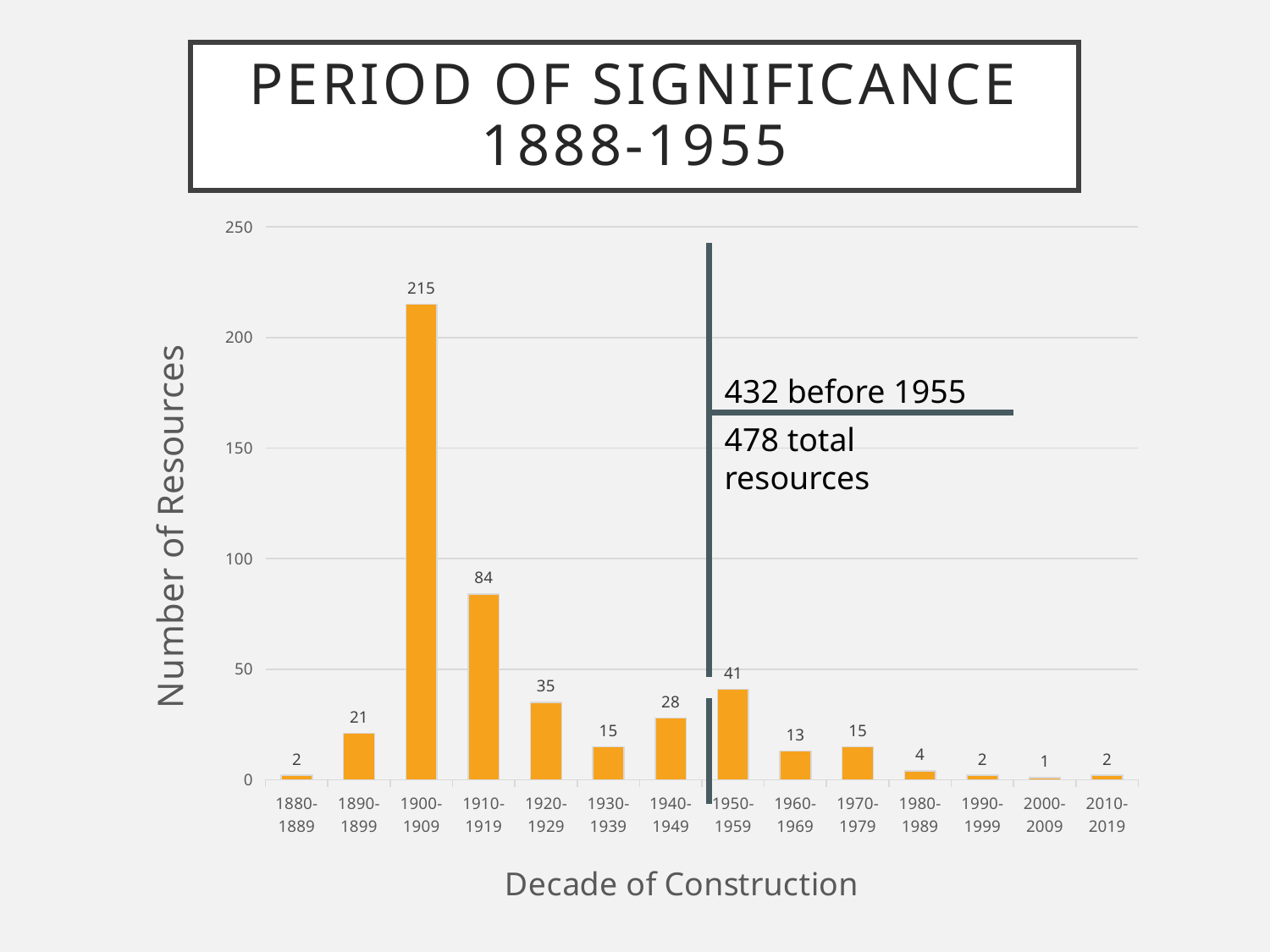
What is the label of the y axis? Number of Resources How many resources were constructed in the decade 1900-1909? 215 How many resources were constructed in 1950-1959? 41 Which decade has more resources, 1920-1929 or 1940-1949? 1920-1929 What kind of chart is shown on the slide? bar chart Is the number of resources for 1900-1909 greater or less than 200? greater Which decade of construction has the highest number of resources? 1900-1909 What is the number of resources for the decade 1910-1919? 84 What is the label of the x axis? Decade of Construction What is the difference in number of resources between 1900-1909 and 1910-1919? 131 Which decade of construction has the lowest number of resources? 2000-2009 How many decades of construction are shown on the x axis? 14